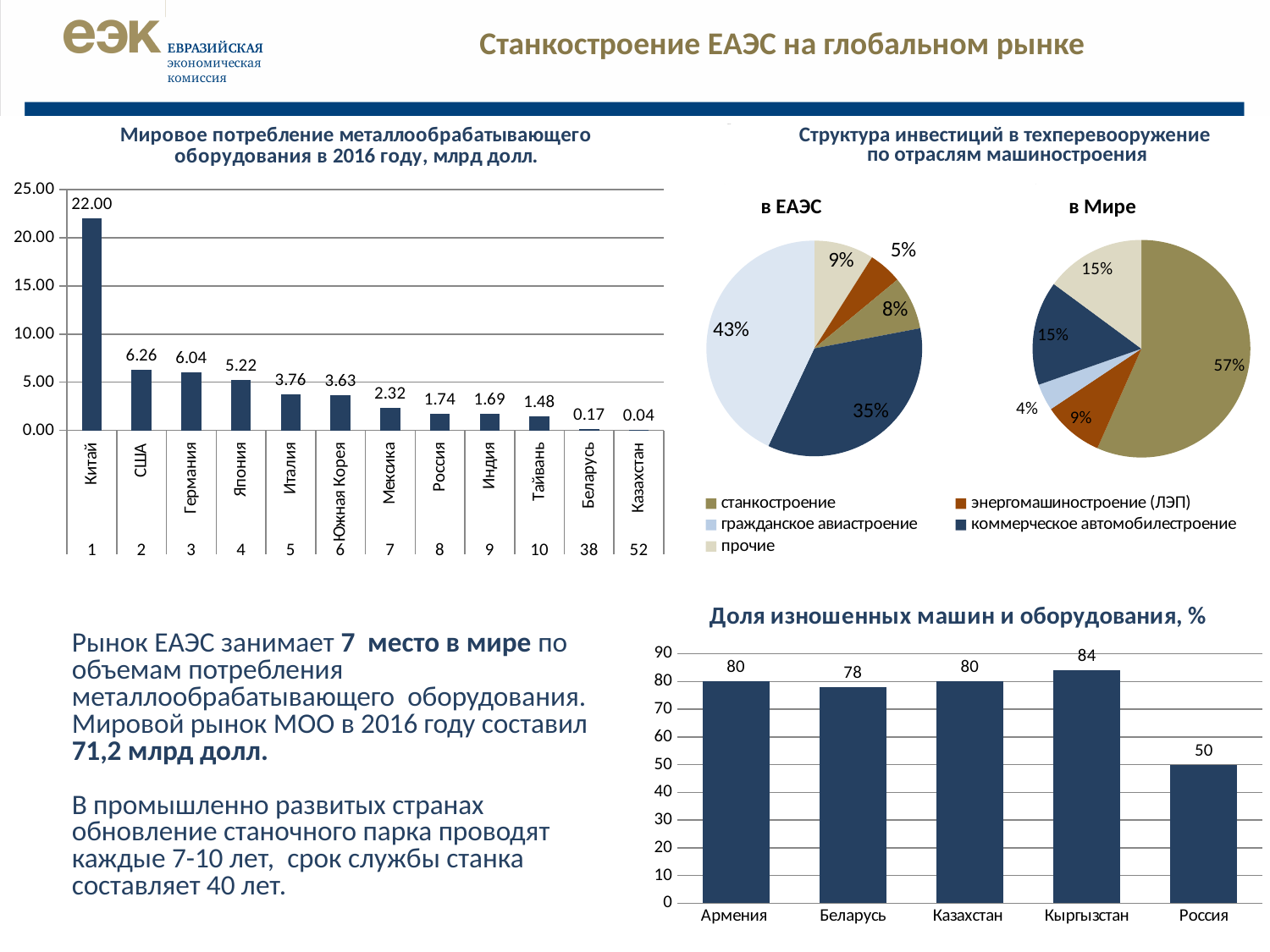
How many categories does the legend of the pie charts 'Структура инвестиций в техперевооружение по отраслям машиностроения' list? 5 On the chart 'Доля изношенных машин и оборудования, %', what is the difference between the values for Кыргызстан and Россия? 34 On the chart 'Мировое потребление металлообрабатывающего оборудования в 2016 году, млрд долл.', which country has the lowest value? Казахстан On the chart 'Мировое потребление металлообрабатывающего оборудования в 2016 году, млрд долл.', how many countries are shown? 12 On the chart 'Мировое потребление металлообрабатывающего оборудования в 2016 году, млрд долл.', do the values rise or fall from left to right? fall On the chart 'Доля изношенных машин и оборудования, %', which country has the highest value? Кыргызстан On the pie chart 'в Мире', what share does станкостроение have? 57% On the chart 'Мировое потребление металлообрабатывающего оборудования в 2016 году, млрд долл.', what is the value for Россия? 1.74 On the chart 'Мировое потребление металлообрабатывающего оборудования в 2016 году, млрд долл.', what is the difference between the values for США and Германия? 0.22 On the pie chart 'в Мире', which is larger: энергомашиностроение (ЛЭП) or гражданское авиастроение? энергомашиностроение (ЛЭП) On the chart 'Мировое потребление металлообрабатывающего оборудования в 2016 году, млрд долл.', what is the value for Китай? 22.00 On the pie chart 'в ЕАЭС', what share does гражданское авиастроение have? 43%